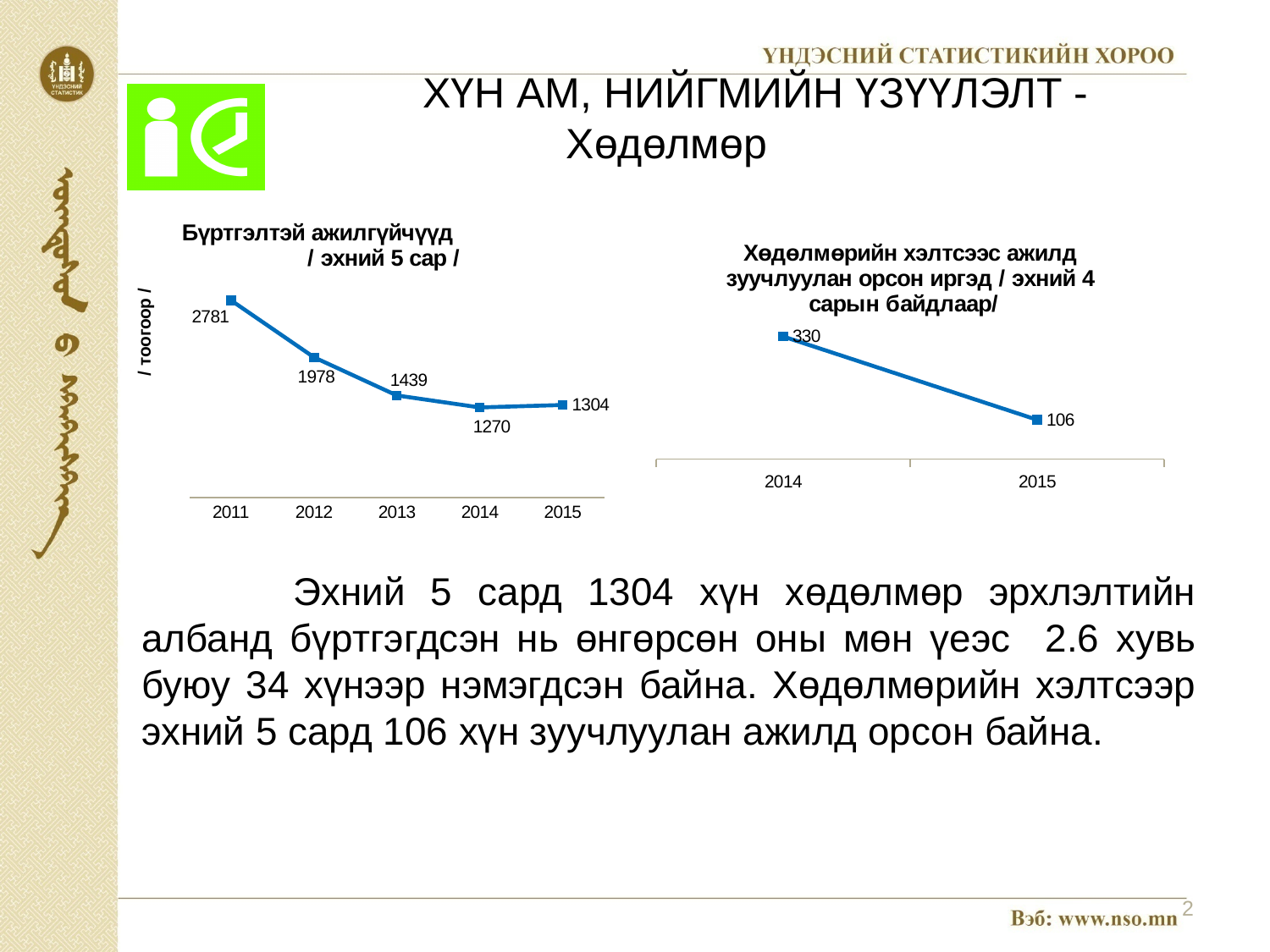
In the left chart (Бүртгэлтэй ажилгүйчүүд), what is the difference between the 2015 and 2014 values? 34 What kind of chart is the left chart (Бүртгэлтэй ажилгүйчүүд)? line chart In the left chart (Бүртгэлтэй ажилгүйчүүд), what is the value for 2011? 2781 In the left chart (Бүртгэлтэй ажилгүйчүүд), which year has the lowest value? 2014 In the left chart (Бүртгэлтэй ажилгүйчүүд), is the value for 2012 larger or smaller than the value for 2013? larger In the right chart (Хөдөлмөрийн хэлтсээс ажилд зуучлуулан орсон иргэд), what is the value for 2014? 330 In the right chart (Хөдөлмөрийн хэлтсээс ажилд зуучлуулан орсон иргэд), do the values rise or fall from 2014 to 2015? fall In the right chart (Хөдөлмөрийн хэлтсээс ажилд зуучлуулан орсон иргэд), what is the value for 2015? 106 In the right chart (Хөдөлмөрийн хэлтсээс ажилд зуучлуулан орсон иргэд), what is the difference between the 2014 and 2015 values? 224 In the left chart (Бүртгэлтэй ажилгүйчүүд), which year has the highest value? 2011 In the left chart (Бүртгэлтэй ажилгүйчүүд), how many years are plotted? 5 In the left chart (Бүртгэлтэй ажилгүйчүүд), what is the value for 2013? 1439